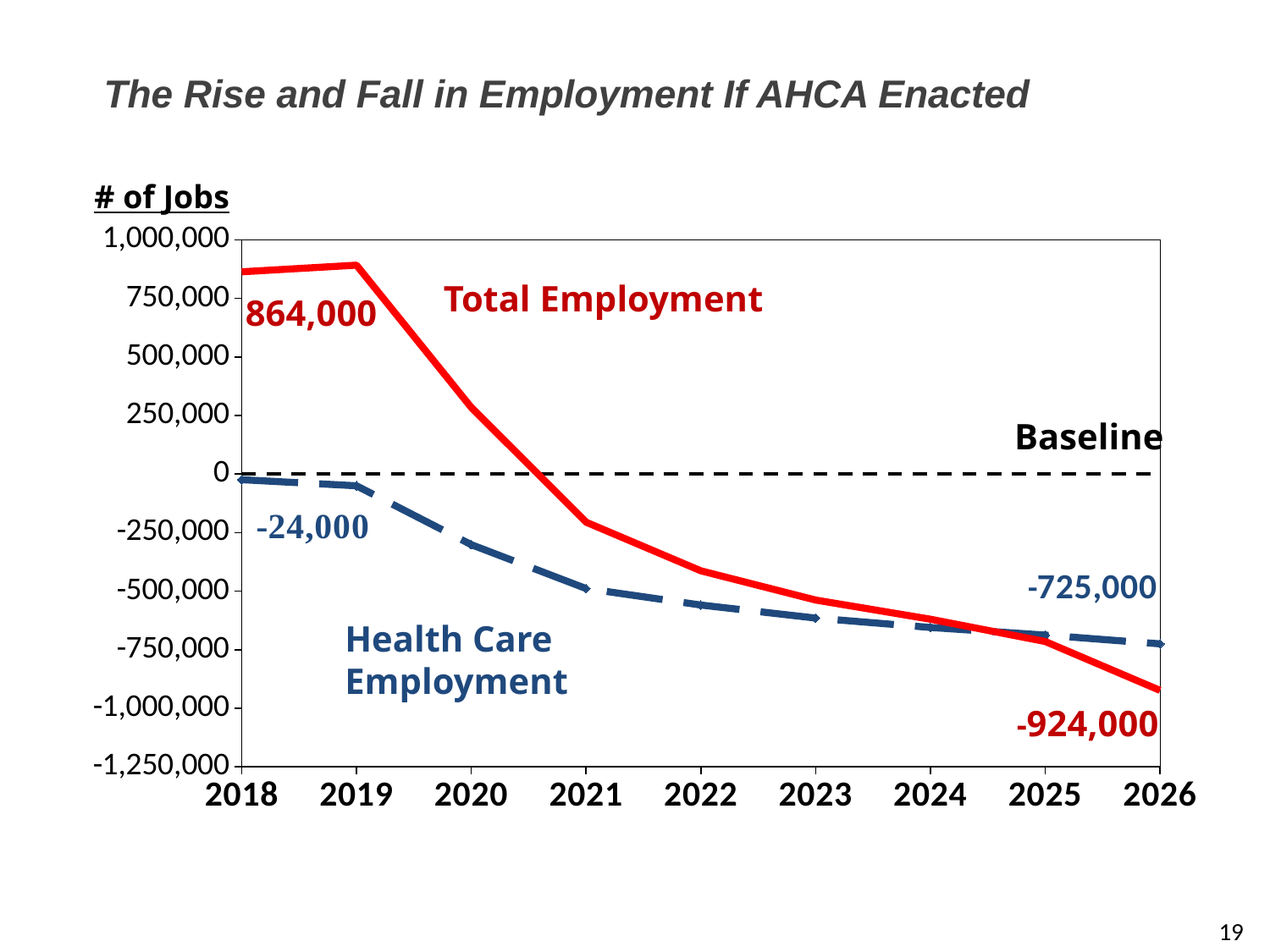
What type of chart is shown on the slide? line chart What is the value of Total Employment in 2018? 864,000 By how much does Total Employment change between 2018 and 2026? 1,788,000 By how much does Health Care Employment fall between 2018 and 2026? 701,000 In 2026, which series has the higher value, Total Employment or Health Care Employment? Health Care Employment What is the label on the vertical axis? # of Jobs What is the value of Health Care Employment in 2026? -725,000 What is the value of Total Employment in 2026? -924,000 Is the value for Total Employment in 2021 greater or less than 0? less In which year does Total Employment reach its highest value? 2019 What is the value of Health Care Employment in 2018? -24,000 How many years are shown on the x axis? 9